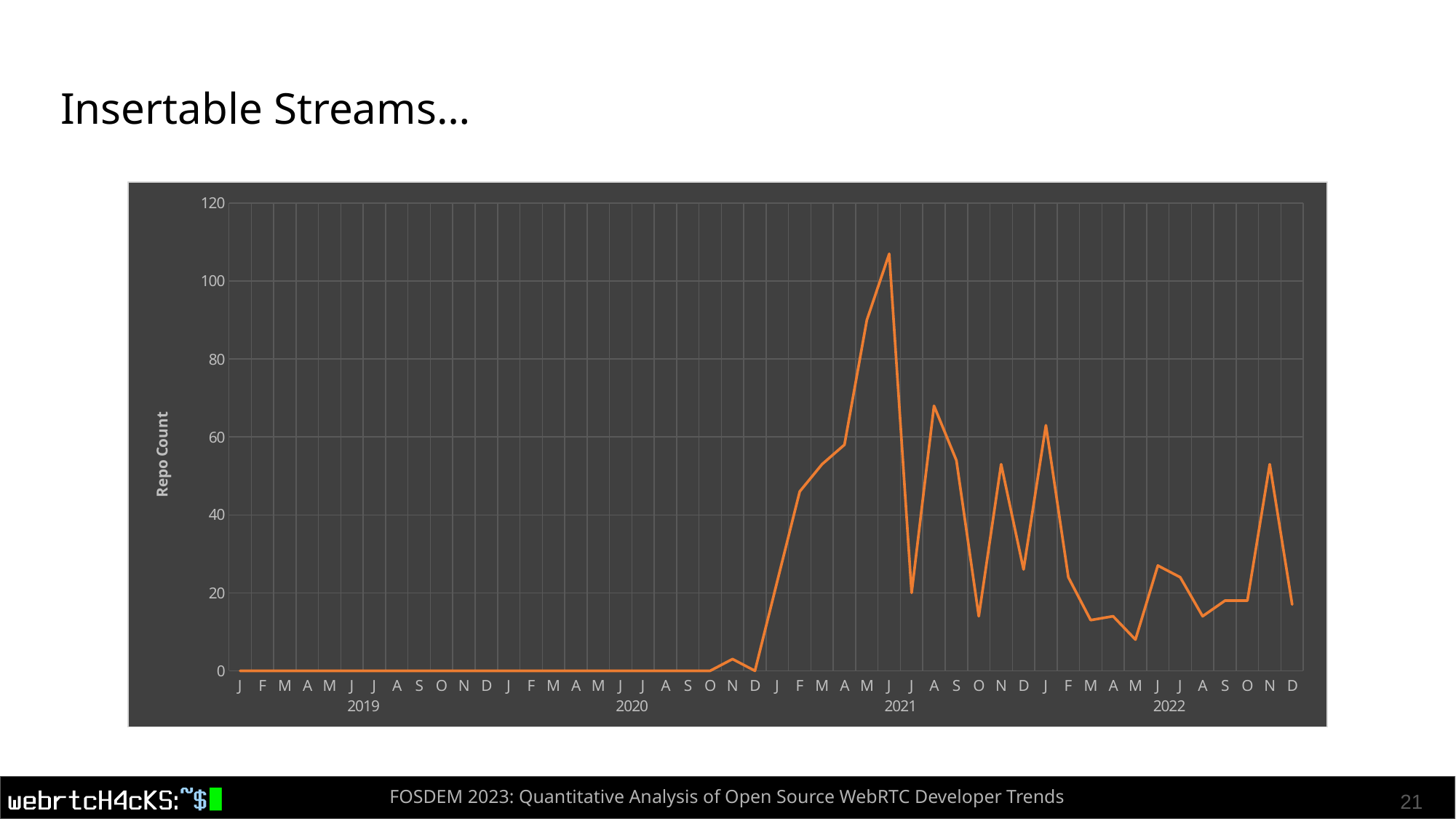
In which month and year does the repo count reach its highest value? June 2021 What kind of chart is shown on the slide? line chart How many years are labelled along the x axis of the chart? 4 Which is larger, the repo count in June 2021 or the repo count in January 2022? June 2021 Is the repo count for December 2022 greater or less than 20? less What is the repo count for January 2019? 0 Does the repo count rise or fall between January 2021 and June 2021? rise What is the title of the slide containing the chart? Insertable Streams... Is the repo count for August 2021 greater or less than 60? greater What is the label on the vertical axis of the chart? Repo Count What is the repo count for June 2020? 0 Is the peak repo count in June 2021 greater or less than 100? greater